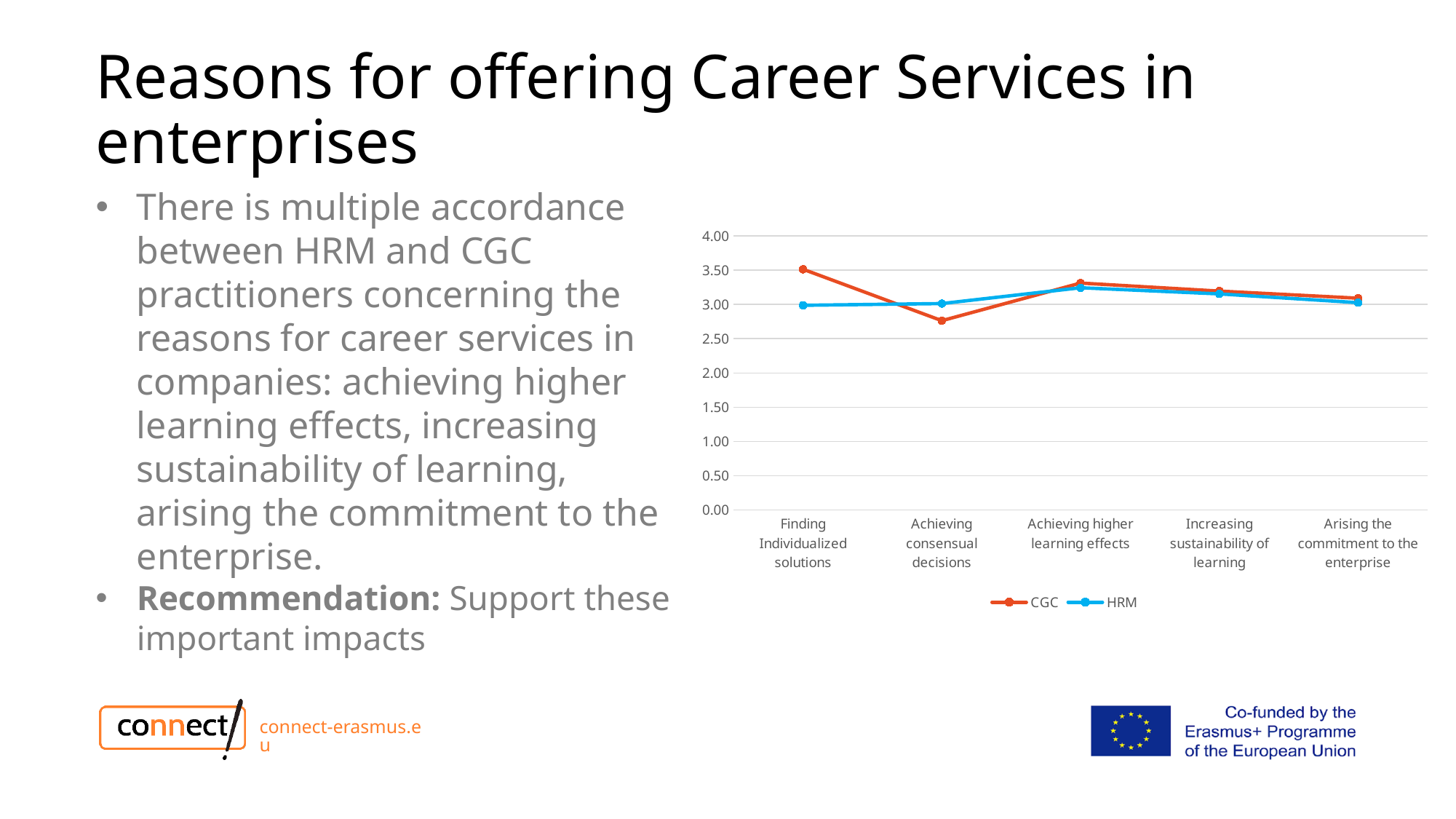
For which category is the CGC value highest? Finding Individualized solutions Is the HRM value for Achieving higher learning effects greater or less than 3.00? greater For Achieving consensual decisions, which series has the larger value, CGC or HRM? HRM What kind of chart is shown on the slide? line chart For which category is the CGC value lowest? Achieving consensual decisions Which series are listed in the chart legend? CGC and HRM How many series does the chart legend list? 2 For Finding Individualized solutions, which series has the larger value, CGC or HRM? CGC Is the CGC value for Finding Individualized solutions greater or less than 3.00? greater What colour is the CGC line in the chart? red How many categories are shown along the x axis of the chart? 5 Is the CGC value for Achieving consensual decisions greater or less than 3.00? less